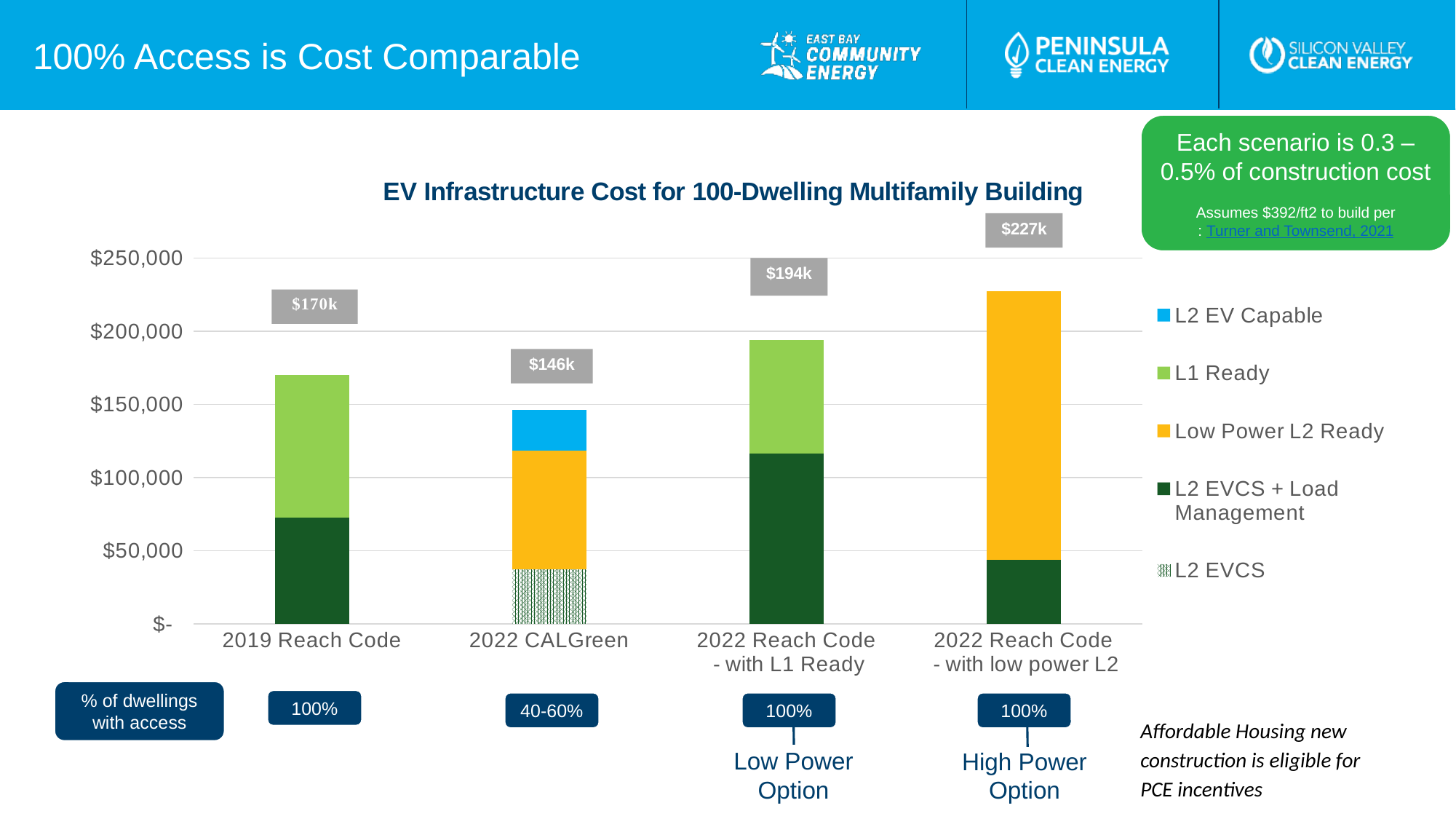
What is the total cost shown for the 2022 Reach Code - with L1 Ready scenario? $194k What is the total cost label shown above the 2022 CALGreen bar? $146k How many series does the chart legend list? 5 What type of chart is used to show EV infrastructure cost? Stacked bar chart What is the total EV infrastructure cost shown for the 2019 Reach Code scenario? $170k Which scenario has the highest total EV infrastructure cost? 2022 Reach Code - with low power L2 How many scenarios (bars) are shown on the x axis of the chart? 4 Which has a larger total cost: 2022 CALGreen or 2022 Reach Code - with L1 Ready? 2022 Reach Code - with L1 Ready What is the difference between the total cost of the 2022 Reach Code - with low power L2 scenario and the 2019 Reach Code scenario? $57k Which scenario has the lowest total EV infrastructure cost? 2022 CALGreen Is the L2 EVCS + Load Management segment for the 2022 Reach Code - with L1 Ready scenario greater or less than $100,000? greater